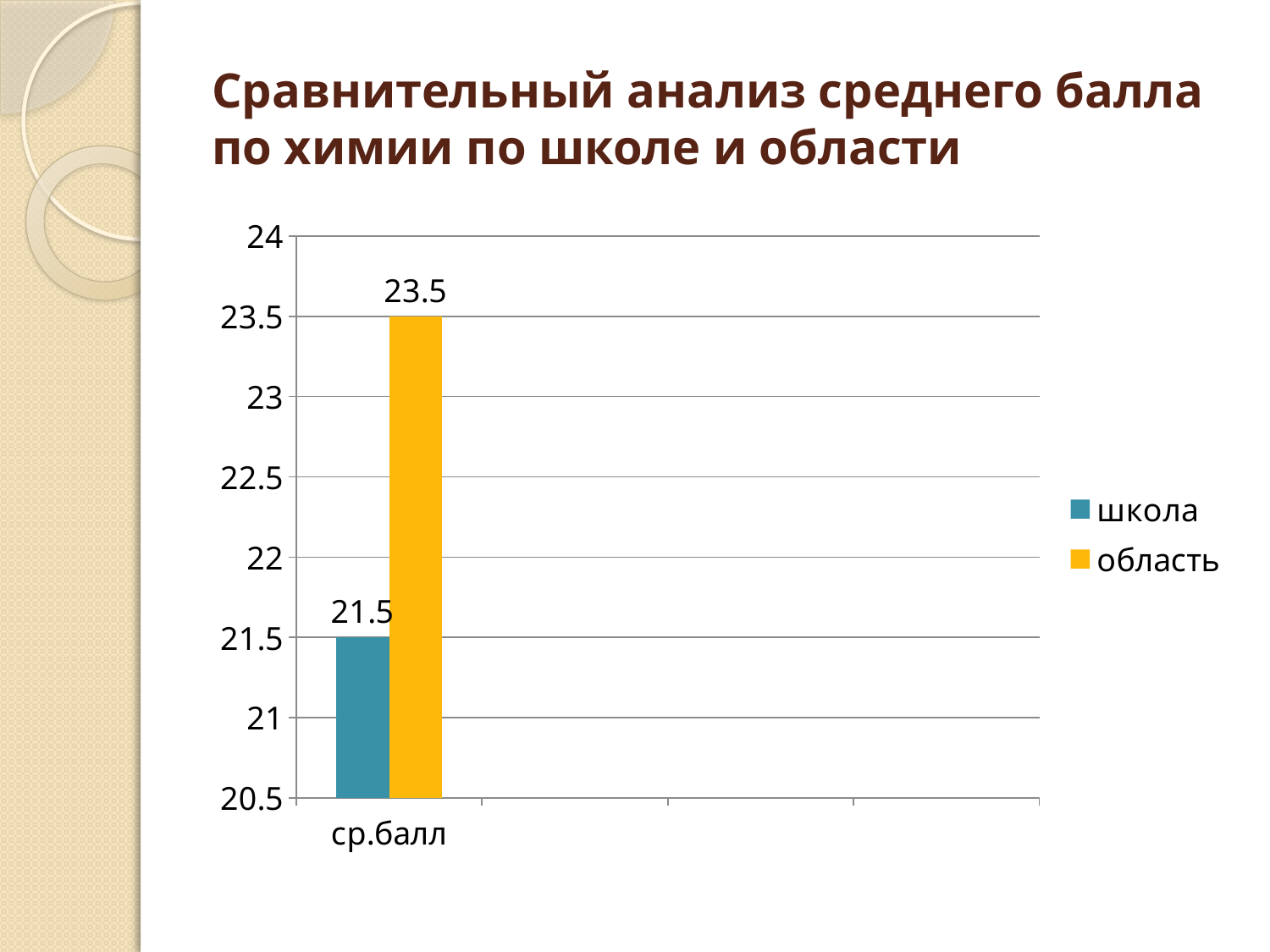
What is the value for область in the ср.балл category? 23.5 What kind of chart is shown on the slide? bar chart Which series has the lowest value on the chart? школа How many categories are shown on the x axis? 1 How many series does the legend list? 2 Which series has the highest value on the chart? область What is the value for школа in the ср.балл category? 21.5 What is the difference between the область value and the школа value? 2 Is the value for область greater or less than 23? greater What colour is the bar for область? yellow Which series has the higher value: школа or область? область Is the value for школа greater or less than 22? less